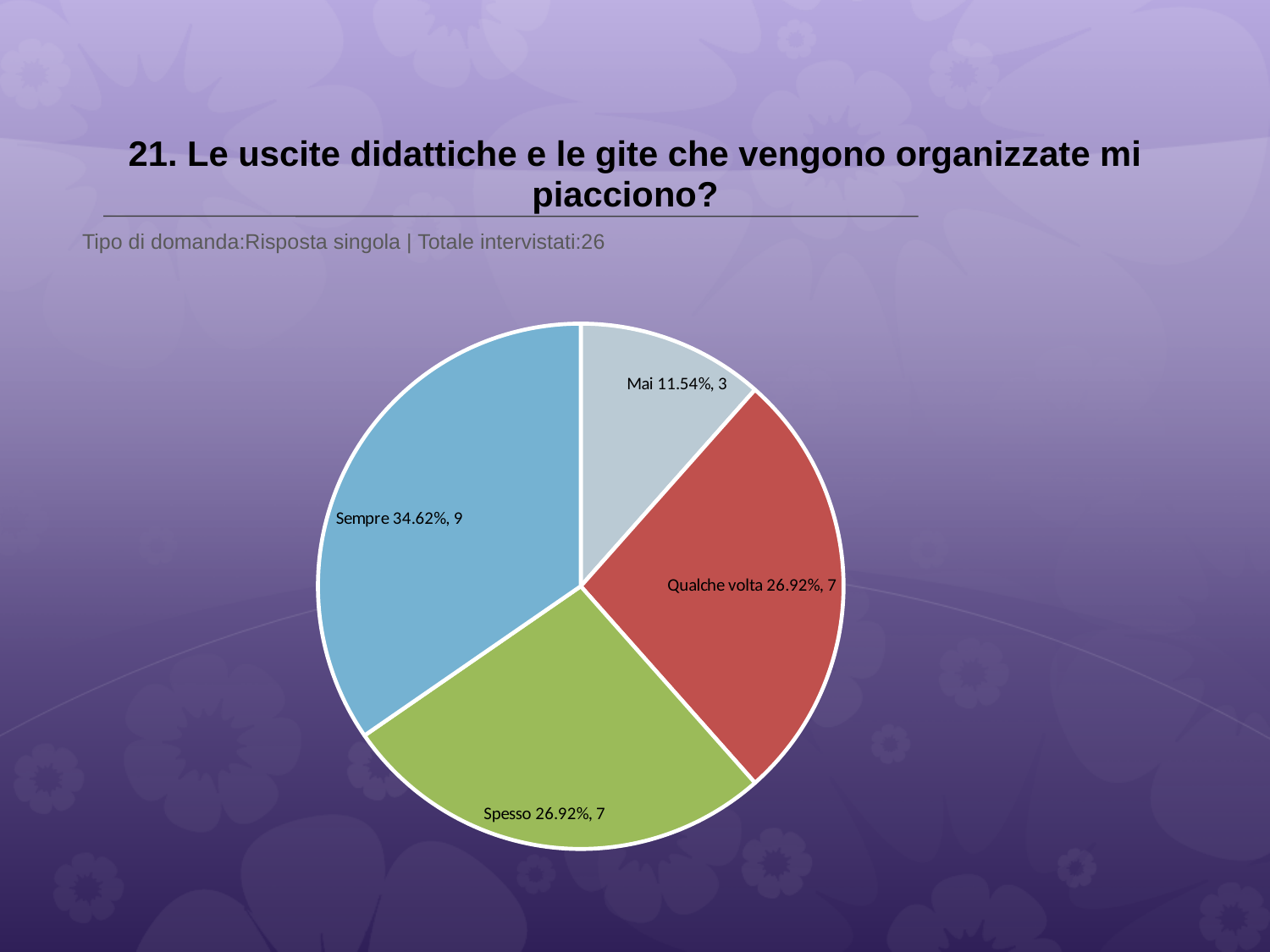
What is the difference in respondent count between 'Sempre' and 'Mai'? 6 What percentage share does the 'Qualche volta' slice have? 26.92% What kind of chart is shown on the slide? pie chart How many respondents answered 'Mai'? 3 Which category has the largest slice? Sempre Which category has the smallest slice? Mai What colour is the 'Spesso' slice? green How many respondents answered 'Spesso'? 7 What is the total number of respondents shown across all slices? 26 What percentage share does the 'Sempre' slice have? 34.62% Which has more respondents, 'Sempre' or 'Qualche volta'? Sempre How many slices does the pie chart have? 4